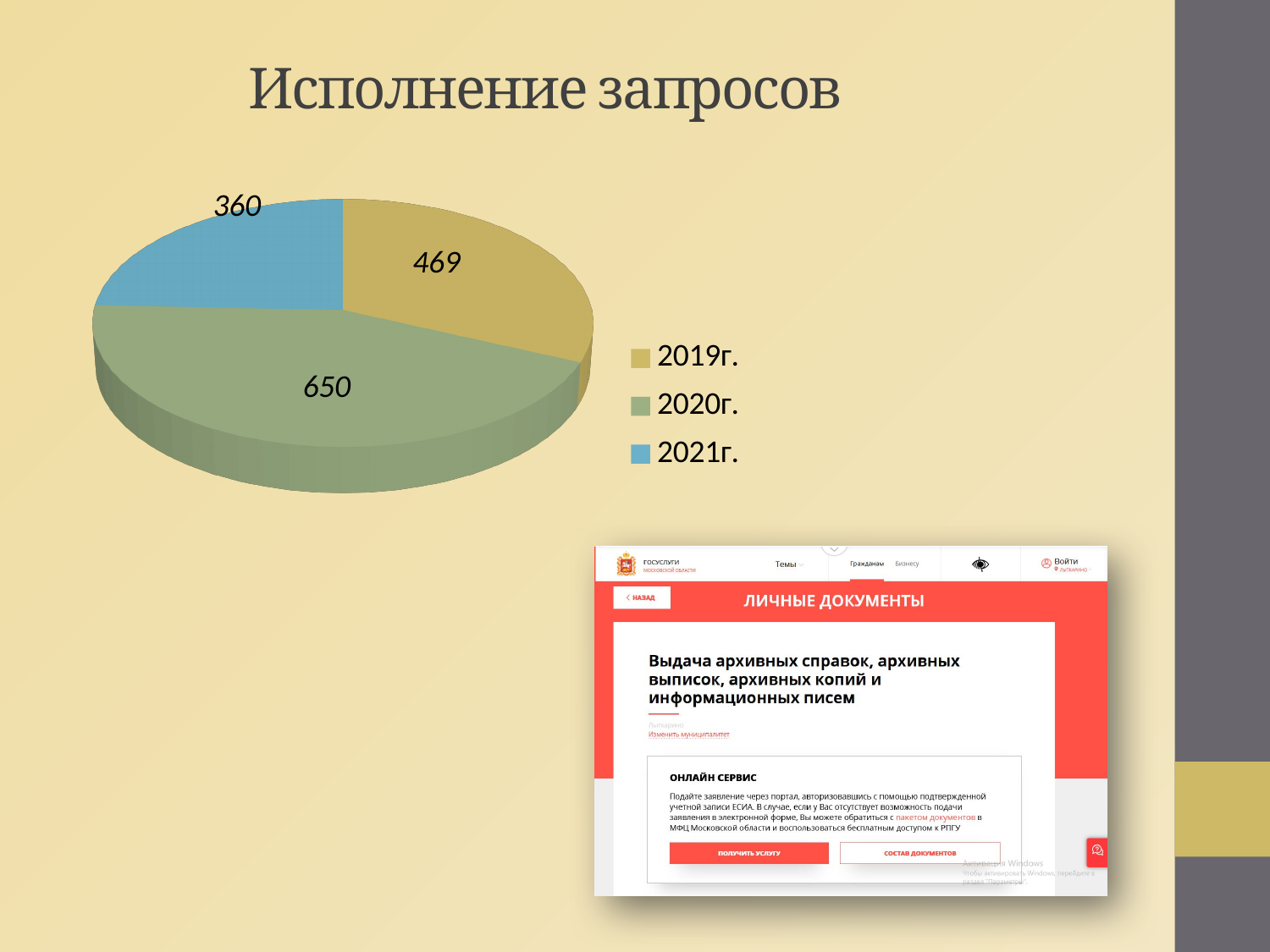
What is the title of the chart on the slide? Исполнение запросов What is the difference between the values for 2020г. and 2019г.? 181 How many slices does the pie chart have? 3 What is the value for 2019г. in the pie chart? 469 Which year has the largest slice in the pie chart? 2020г. Which is larger, the value for 2019г. or the value for 2021г.? 2019г. What type of chart is shown on the slide? pie chart What is the value for 2021г. in the pie chart? 360 Which colour represents 2021г. in the pie chart? blue Which year has the smallest slice in the pie chart? 2021г. What is the difference between the values for 2019г. and 2021г.? 109 What is the value for 2020г. in the pie chart? 650